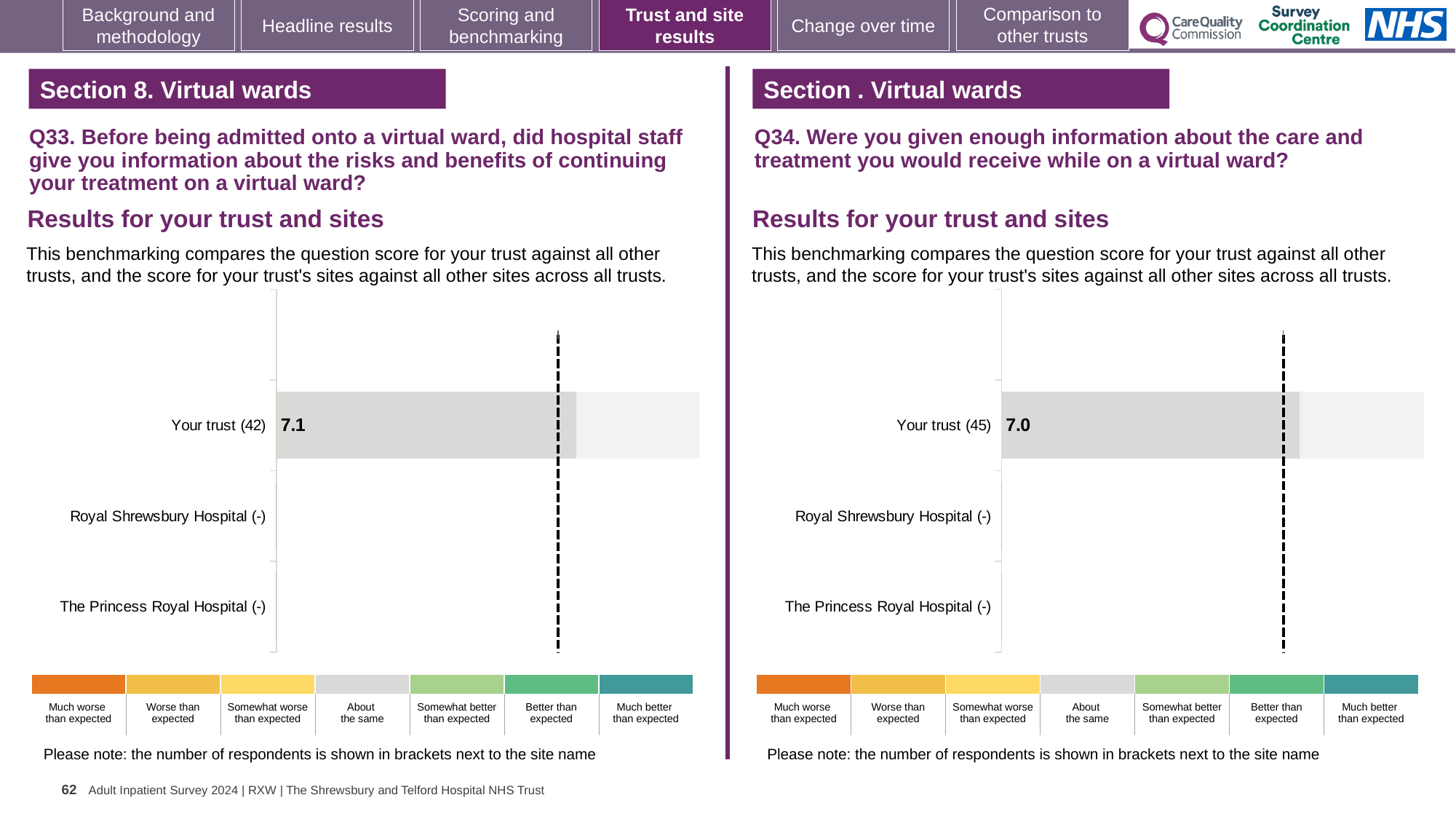
On the Q34 chart (right), how many benchmark bands are shown in the colour key below the chart? 7 On the Q33 chart (left), what is the score shown for Your trust? 7.1 Which is larger: the Your trust score on the Q33 chart (left) or the Your trust score on the Q34 chart (right)? Q33 chart (7.1) On the Q33 chart (left), how many respondents are shown in brackets next to Your trust? 42 On the Q34 chart (right), what is the score shown for Your trust? 7.0 What kind of chart is the Q33 chart on the left? Bar chart On the Q33 chart (left), which category has the highest score shown? Your trust (42) On the Q34 chart (right), how many categories are listed on the vertical axis? 3 On the Q33 chart (left), what is the label of the category listed at the bottom of the vertical axis? The Princess Royal Hospital (-) On the Q34 chart (right), how many respondents are shown in brackets next to Your trust? 45 What is the difference between the Your trust score on the Q33 chart (left) and the Your trust score on the Q34 chart (right)? 0.1 On the Q33 chart (left), how many categories are listed on the vertical axis? 3